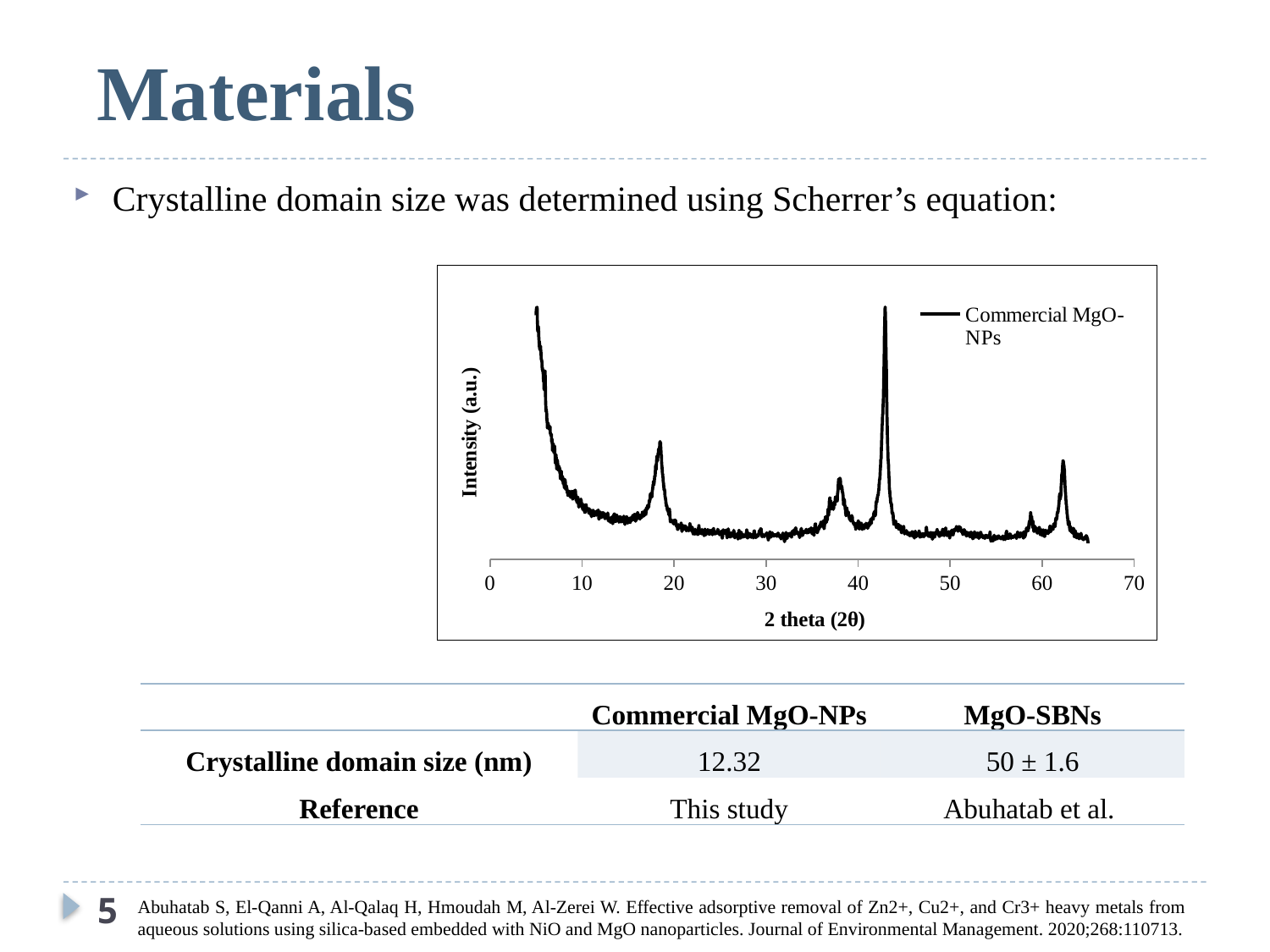
Does the intensity rise or fall along the x axis between 2 theta of 5 and 10? fall Is the 2 theta position of the first peak after the initial decline greater or less than 10? greater How many series does the chart legend list? 1 What is the label of the x axis of the chart? 2 theta (2θ) Is the 2 theta position of the tallest peak in the chart greater or less than 50? less What is the largest tick value shown on the x axis of the chart? 70 What kind of chart is shown on the slide? line chart How many tick labels are shown on the x axis of the chart? 8 What series name is shown in the chart legend? Commercial MgO-NPs Is the 2 theta position of the tallest peak in the chart greater or less than 40? greater